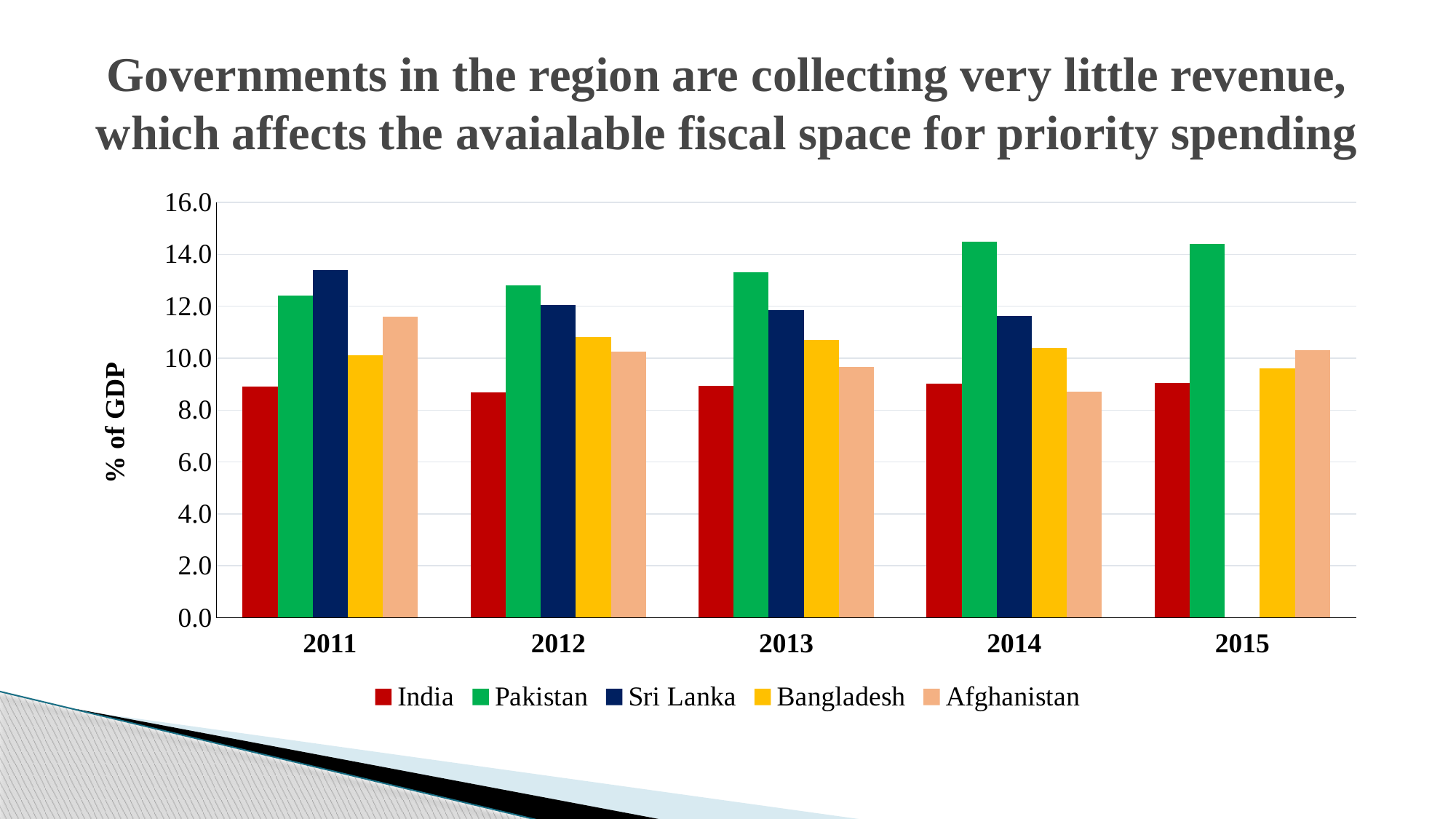
In 2011, which is larger: the value for Sri Lanka or the value for Pakistan? Sri Lanka Is the value for Afghanistan in 2014 greater or less than 10.0? less What kind of chart is shown on the slide? bar chart How many countries does the legend list? 5 Which country has the lowest value in 2011? India What is the label on the y axis? % of GDP Is the value for Pakistan in 2014 greater or less than 14.0? greater Does the value for Pakistan rise or fall from 2011 to 2014? rise Is the value for India in 2011 greater or less than 8.0? greater Which country has the highest value in 2014? Pakistan In 2012, which is larger: the value for Bangladesh or the value for Afghanistan? Bangladesh How many years are shown on the x axis? 5